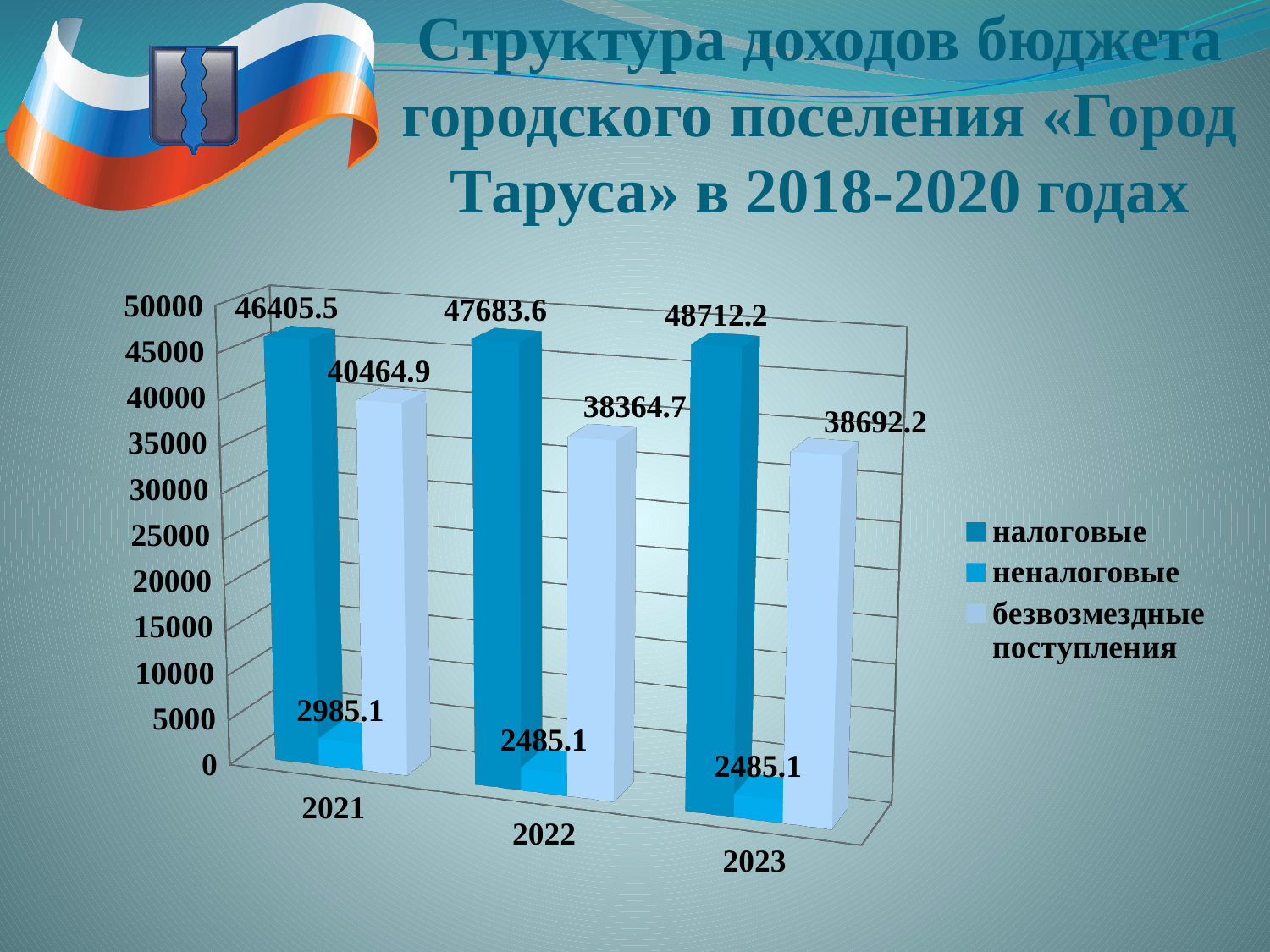
What is the difference between the неналоговые values for 2021 and 2022? 500 How many series does the legend list? 3 What is the difference between the налоговые values for 2023 and 2021? 2306.7 In which year is the value of налоговые highest? 2023 What is the value of налоговые for 2021? 46405.5 Is the value of безвозмездные поступления for 2021 greater or less than 35000? greater How many years are shown on the x axis? 3 Do the налоговые values rise or fall from 2021 to 2023? rise In which year is the value of безвозмездные поступления lowest? 2022 What is the value of неналоговые for 2023? 2485.1 Which is larger in 2023: налоговые or безвозмездные поступления? налоговые What is the value of безвозмездные поступления for 2022? 38364.7